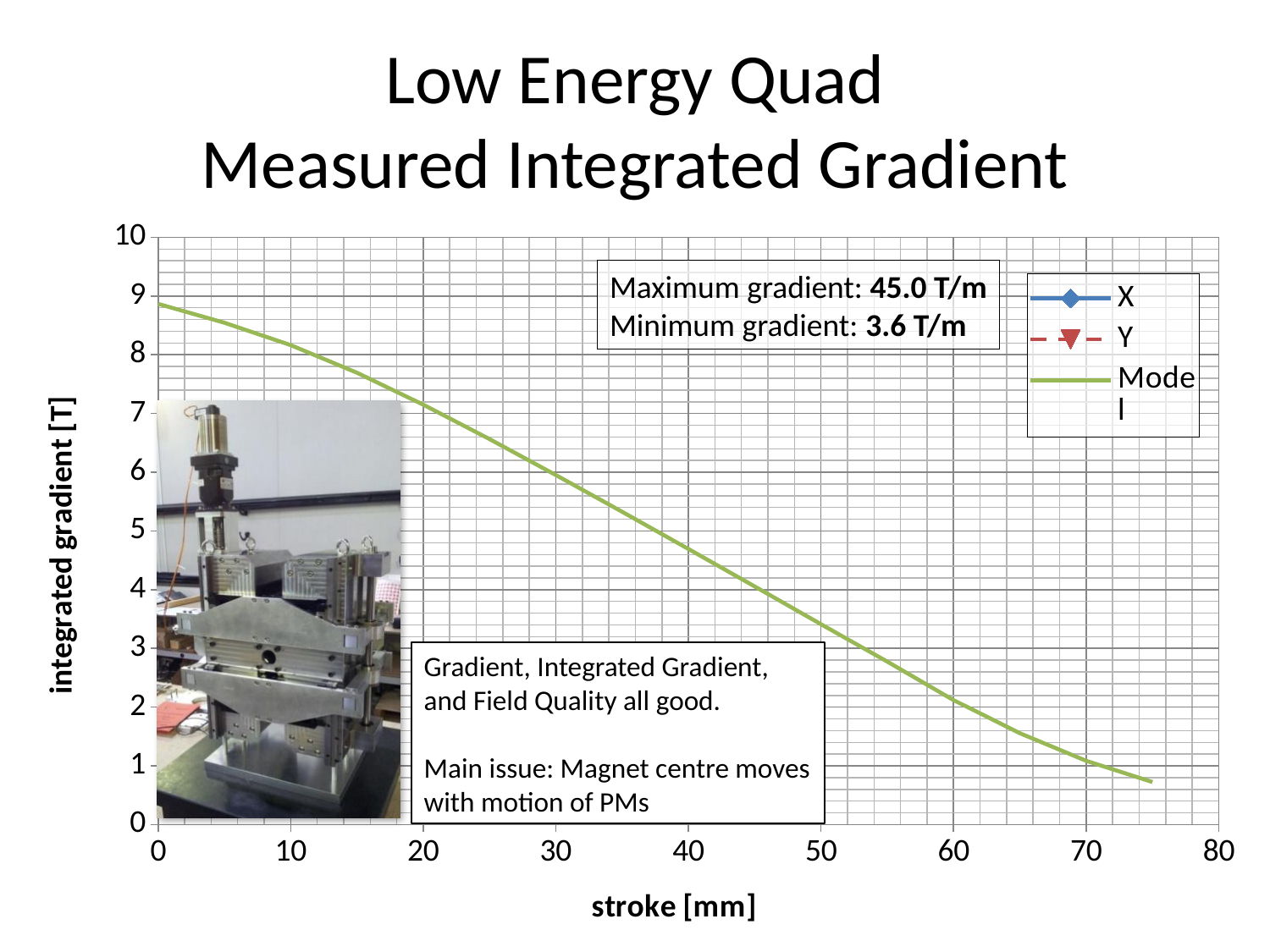
Is the Model value at a stroke of 75 mm greater or less than 1? less What is the label of the chart's x axis? stroke [mm] At which stroke value does the Model series reach its highest integrated gradient? 0 Does the Model series rise or fall as stroke increases from 0 to 75 mm? fall Which is larger for the Model series: the value at a stroke of 10 mm or at 60 mm? 10 mm Is the Model value at a stroke of 10 mm greater or less than 8? greater What is the label of the chart's y axis? integrated gradient [T] How many series does the chart legend list? 3 Is the Model value at a stroke of 0 mm greater or less than 8? greater What kind of chart is shown on the slide? line chart